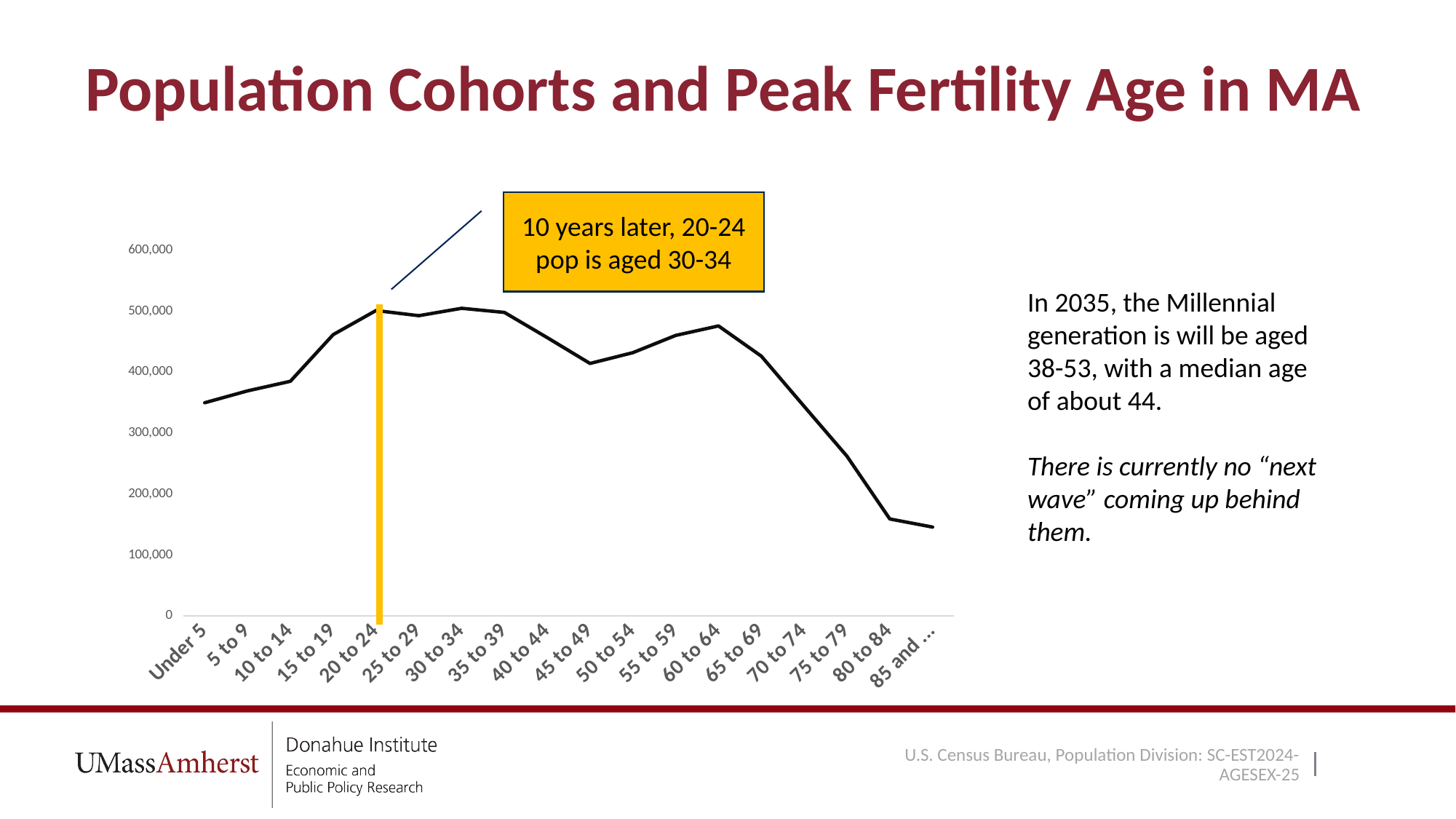
Which age category has the lowest value on the chart? 85 and over Is the value for 70 to 74 greater or less than 300,000? greater Is the value for 60 to 64 greater or less than 500,000? less Which is larger, the value for Under 5 or the value for 60 to 64? 60 to 64 Is the value for 75 to 79 greater or less than 300,000? less What kind of chart is shown on the slide? line chart At which age category is the vertical yellow marker line placed on the chart? 20 to 24 Do the values rise or fall from Under 5 through 20 to 24? rise How many age categories are plotted along the x axis? 18 Do the values rise or fall from 60 to 64 through 85 and over? fall